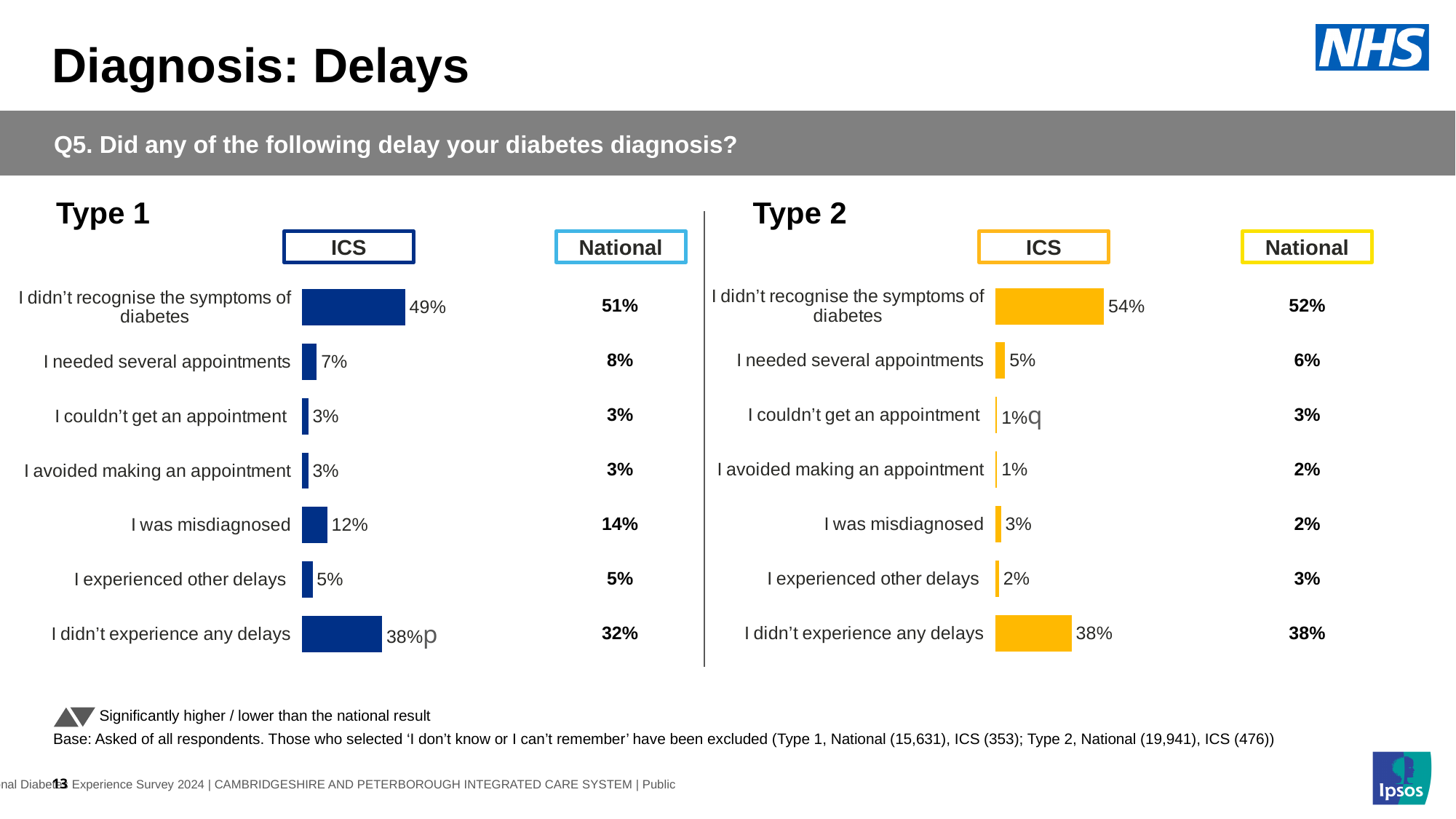
How many categories are shown on the Type 1 chart? 7 On the Type 1 chart, which category has the highest ICS value? I didn't recognise the symptoms of diabetes On the Type 1 chart, which has a larger ICS value: 'I was misdiagnosed' or 'I needed several appointments'? I was misdiagnosed On the Type 2 chart, what is the ICS value for 'I didn't experience any delays'? 38% On the Type 1 chart, what is the ICS value for 'I didn't recognise the symptoms of diabetes'? 49% On the Type 1 chart, what is the difference between the ICS values for 'I didn't recognise the symptoms of diabetes' and 'I didn't experience any delays'? 11% On the Type 2 chart, what is the difference between the ICS values for 'I didn't recognise the symptoms of diabetes' and 'I didn't experience any delays'? 16% What kind of chart is the Type 2 chart? Bar chart On the Type 2 chart, what is the ICS value for 'I needed several appointments'? 5% On the Type 1 chart, what is the ICS value for 'I was misdiagnosed'? 12% What colour are the ICS bars on the Type 2 chart? Yellow On the Type 2 chart, which category has the highest ICS value? I didn't recognise the symptoms of diabetes